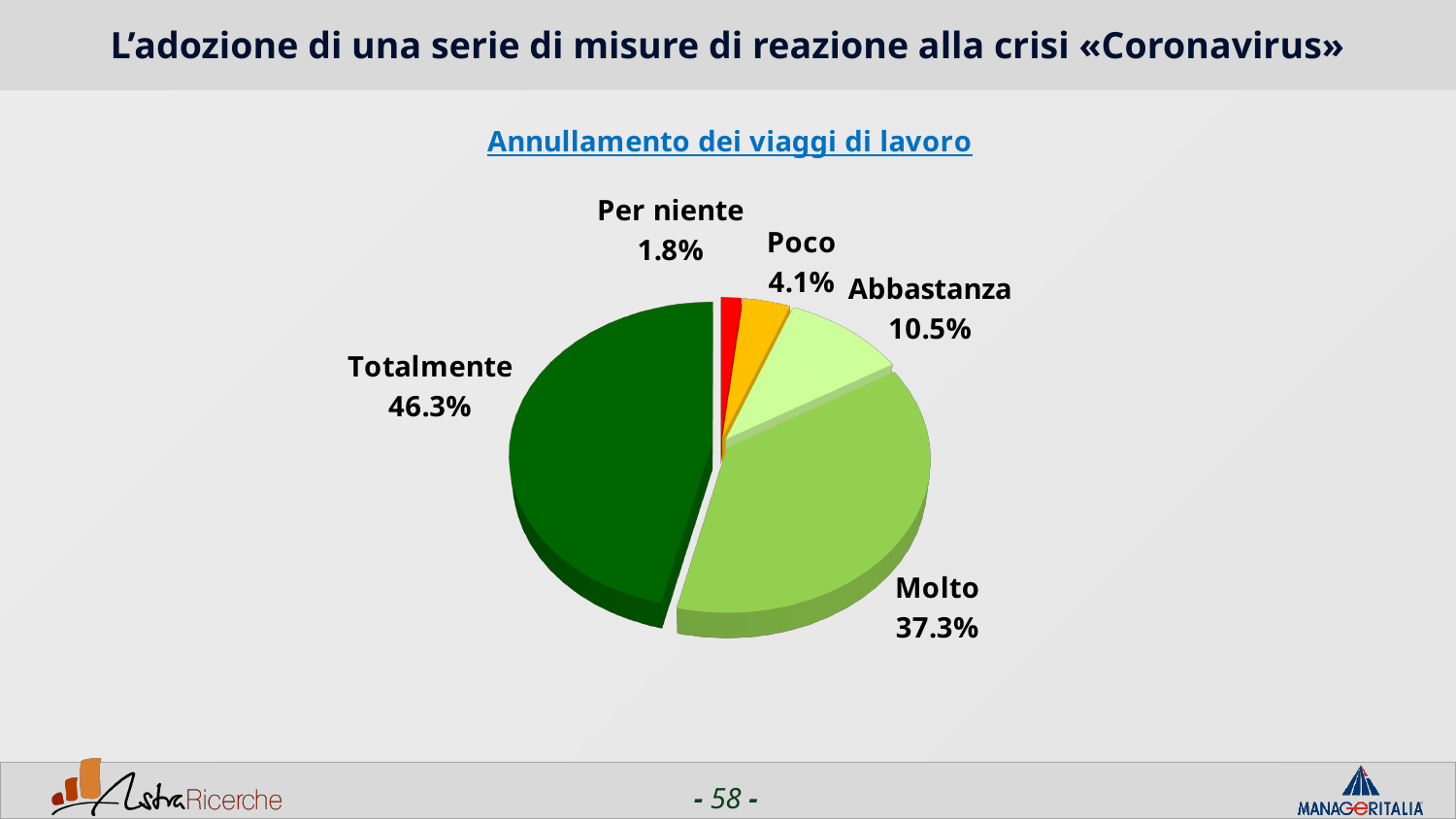
What is the value for "Totalmente"? 46.3% Which category has the smallest share of the pie? Per niente What kind of chart is shown on the slide? pie chart How many categories are shown in the pie chart? 5 What is the difference between the values for "Totalmente" and "Molto"? 9.0% Which category has the largest share of the pie? Totalmente What is the value for "Poco"? 4.1% What is the value for "Abbastanza"? 10.5% What is the value for "Per niente"? 1.8% Which is larger, the value for "Abbastanza" or the value for "Poco"? Abbastanza What is the value for "Molto"? 37.3% What is the title of the chart? Annullamento dei viaggi di lavoro